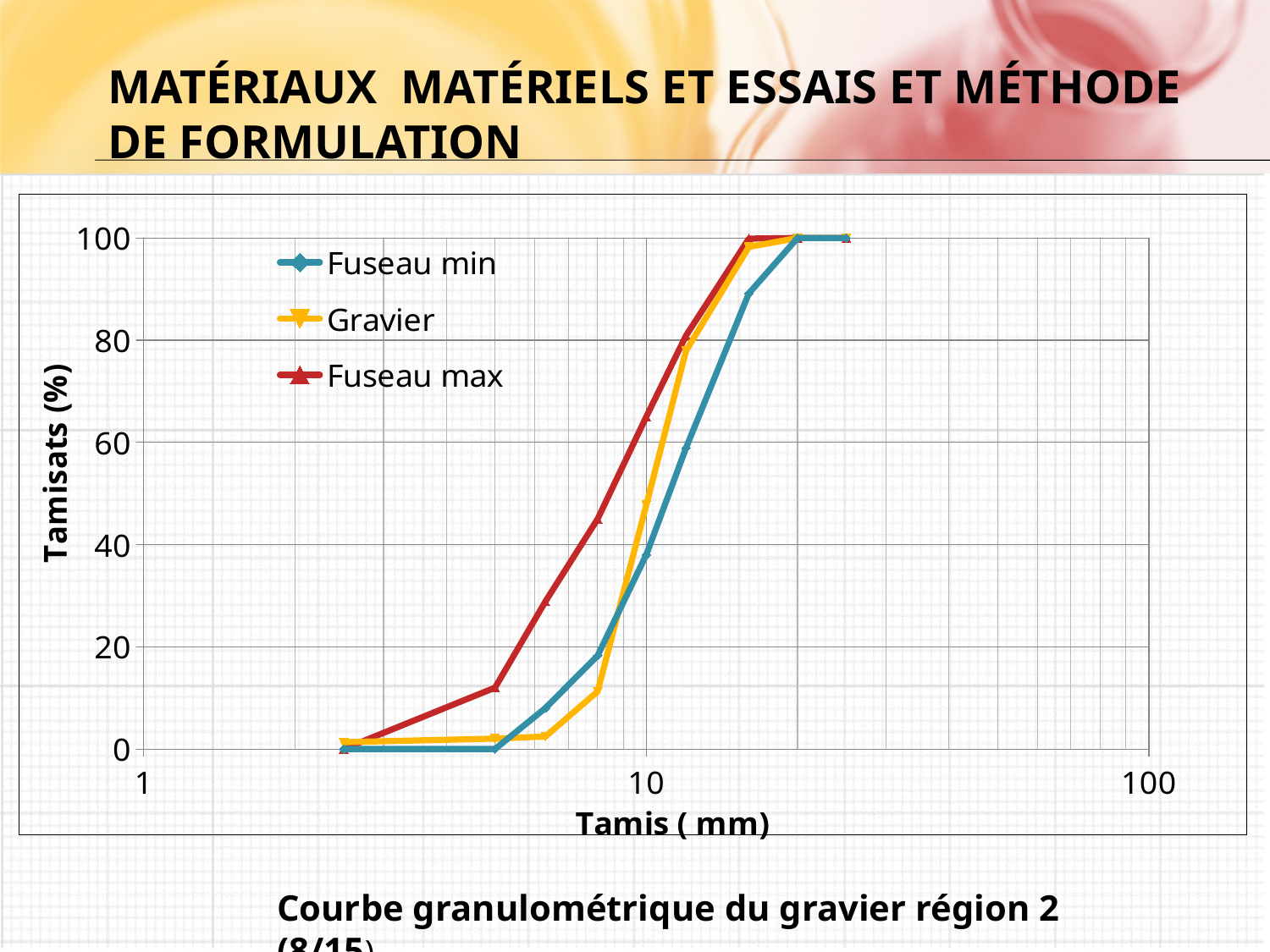
Do the values of the Gravier series rise or fall as the sieve size (Tamis) increases? rise At 10 mm, which is larger: the value for Fuseau max or the value for Fuseau min? Fuseau max At 10 mm, which series has the lowest value? Fuseau min How many series does the legend list? 3 What kind of chart is shown on the slide? line chart At 10 mm, which series has the highest value? Fuseau max What are the three series named in the legend? Fuseau min, Gravier, Fuseau max Is the value for Gravier at 10 mm greater or less than 60? less What is the maximum value reached by the Fuseau min series? 100 What is the title of the vertical axis? Tamisats (%)